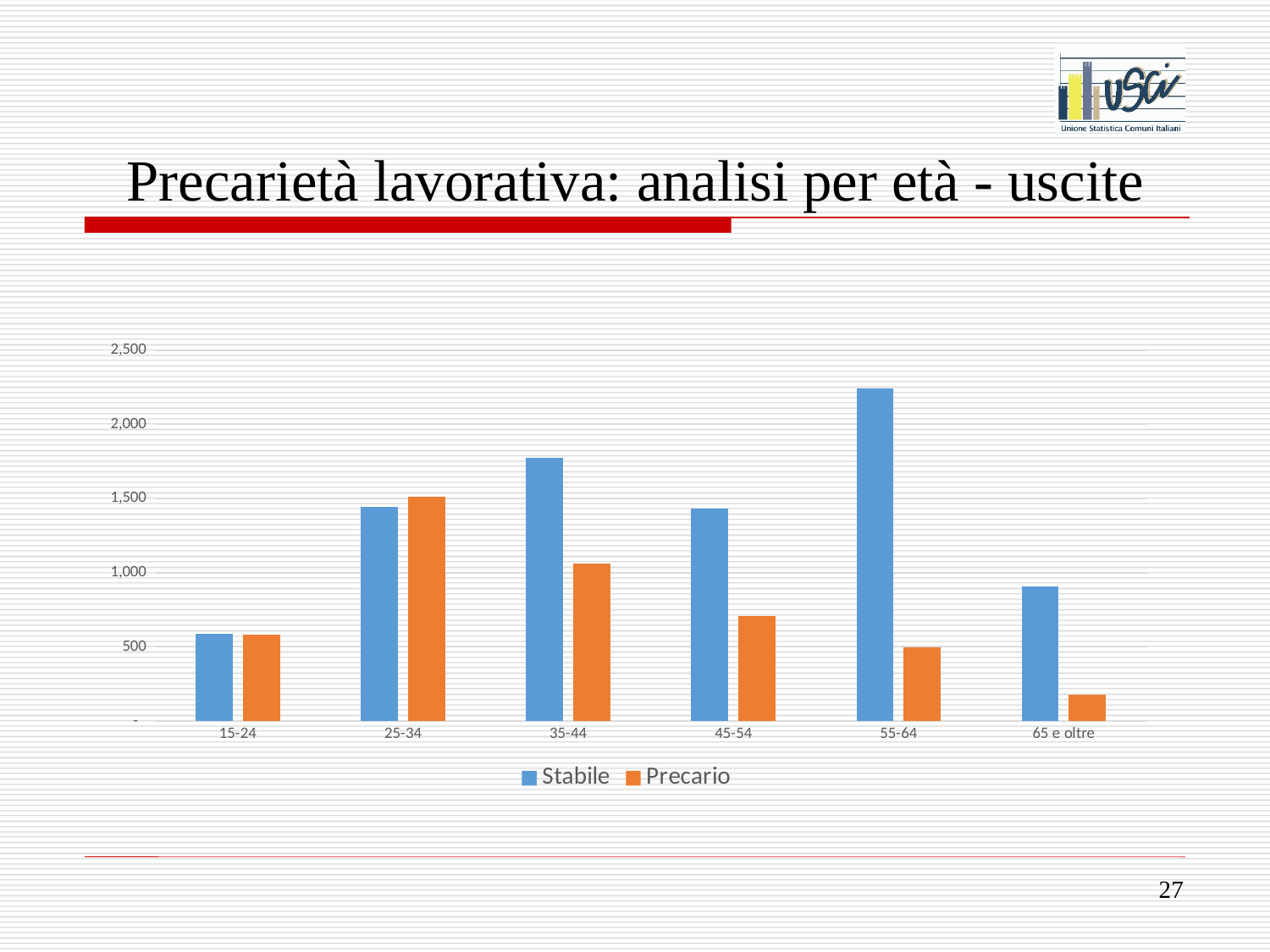
Is the Precario value for 65 e oltre greater or less than 500? less For the 45-54 category, which is larger, Stabile or Precario? Stabile Which age category has the highest Stabile value? 55-64 How many age categories are shown on the x axis? 6 Which age category has the lowest Precario value? 65 e oltre Is the Stabile value for 55-64 greater or less than 2,000? greater Is the Stabile value for 35-44 greater or less than 1,500? greater How many series does the legend list? 2 What kind of chart is shown on the slide? bar chart Which age category has the highest Precario value? 25-34 Which colour represents the Precario series in the legend? orange Which age category has the lowest Stabile value? 15-24